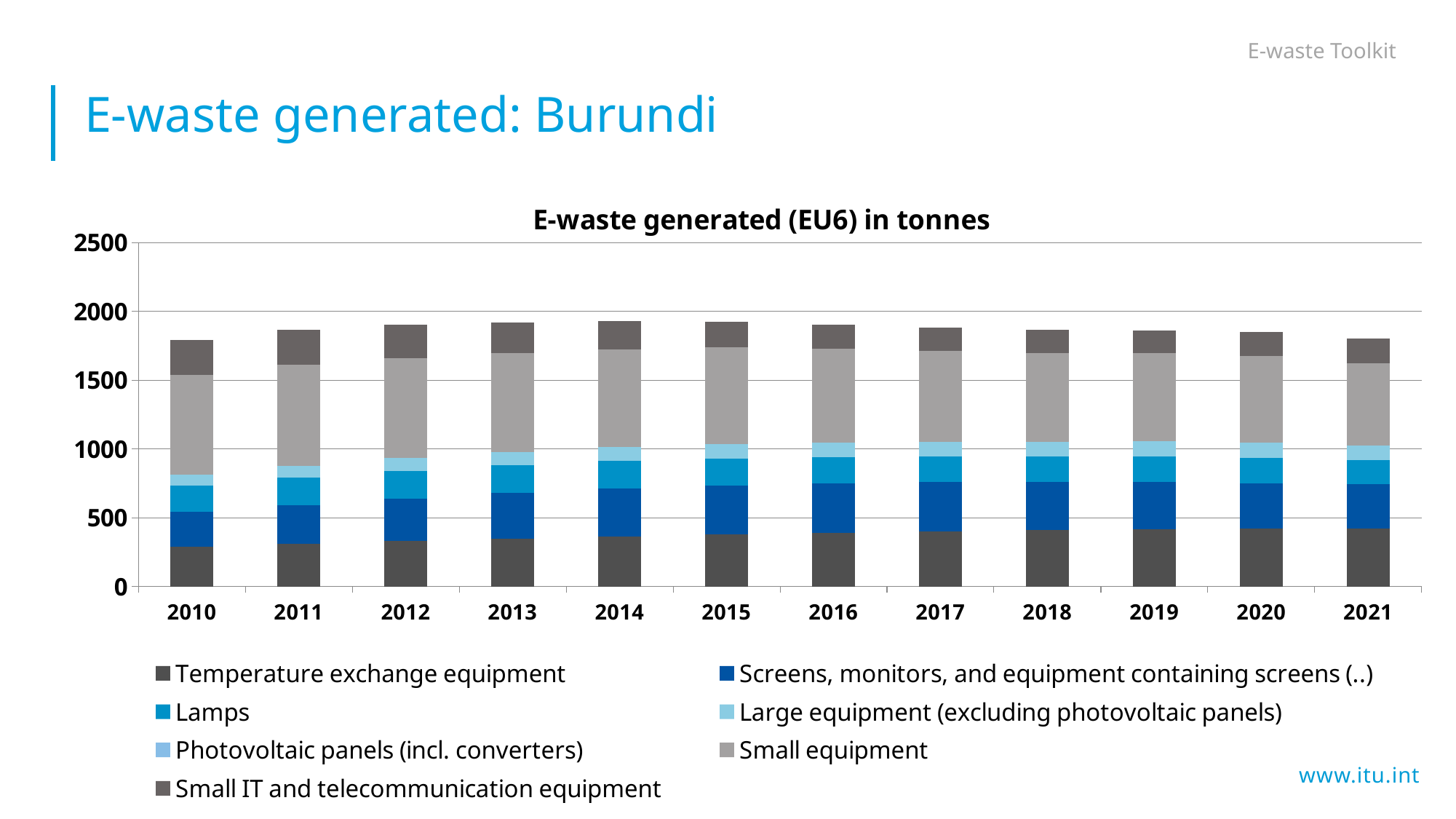
What kind of chart is shown on the slide? Stacked bar chart How many series does the chart's legend list? 7 Is the Temperature exchange equipment value for 2010 greater or less than 500 tonnes? less Is the total e-waste generated in 2010 greater or less than 2000 tonnes? less Is the total e-waste generated in 2021 greater or less than 2000 tonnes? less Which year has the larger total e-waste generated, 2013 or 2021? 2013 How many years are shown on the x axis of the chart? 12 Does the Temperature exchange equipment segment rise or fall from 2010 to 2021? rise Which year has the larger total e-waste generated, 2010 or 2014? 2014 Which series forms the bottom segment of each stacked bar? Temperature exchange equipment What is the title of the chart? E-waste generated (EU6) in tonnes